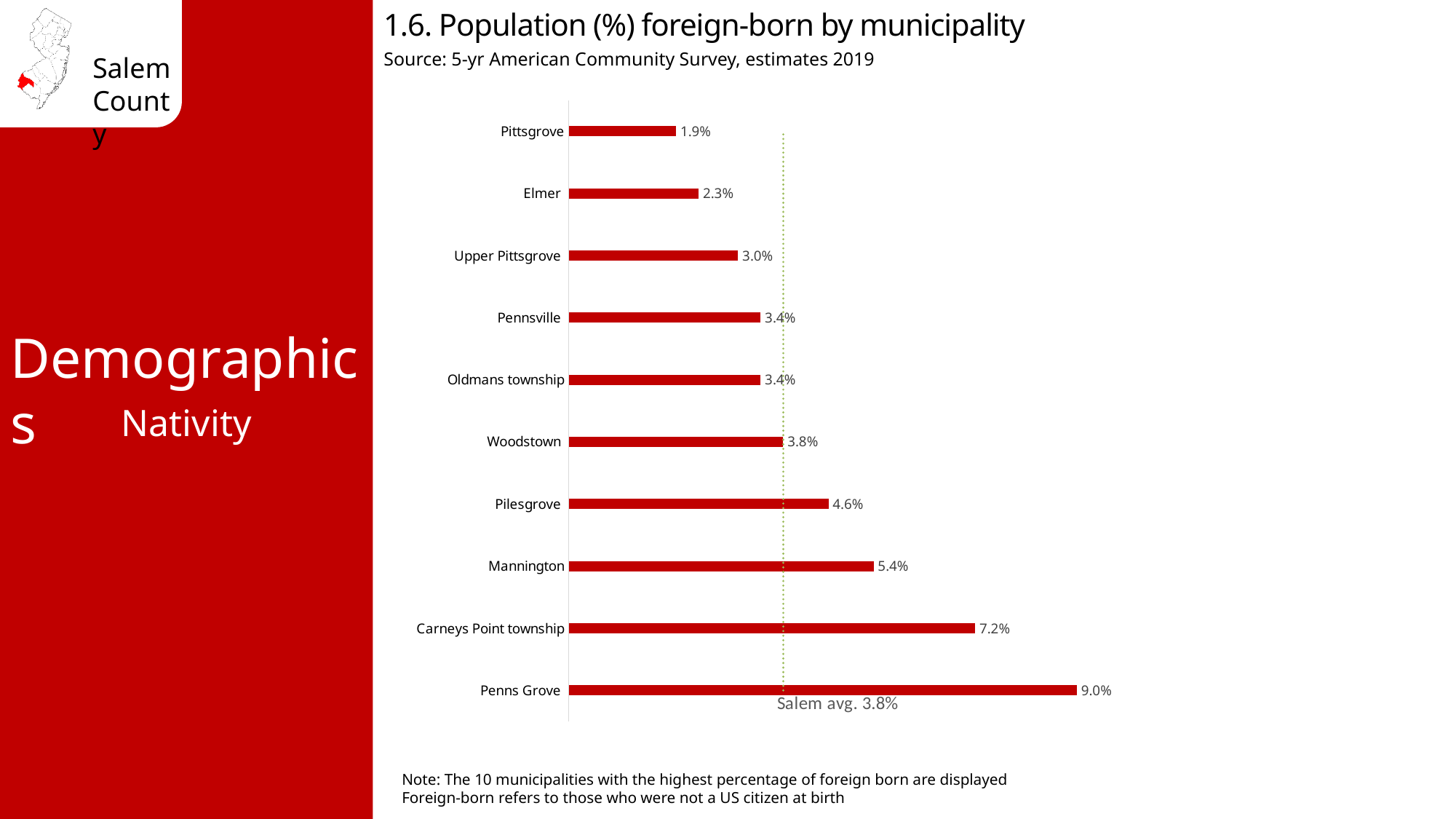
Which municipality has the lowest percentage of foreign-born population? Pittsgrove What is the percentage of foreign-born population in Carneys Point township? 7.2% What is the difference in foreign-born percentage between Woodstown and Pittsgrove? 1.9% How many municipalities are shown in the chart? 10 What is the percentage of foreign-born population in Elmer? 2.3% What is the source of the data shown in the chart? 5-yr American Community Survey, estimates 2019 What is the difference in foreign-born percentage between Penns Grove and Carneys Point township? 1.8% Which municipality has the highest percentage of foreign-born population? Penns Grove What type of chart is used on this slide? Bar chart What is the percentage of foreign-born population in Penns Grove? 9.0% What is the Salem average foreign-born percentage marked by the dotted line? 3.8% Which has a higher foreign-born percentage, Mannington or Pilesgrove? Mannington